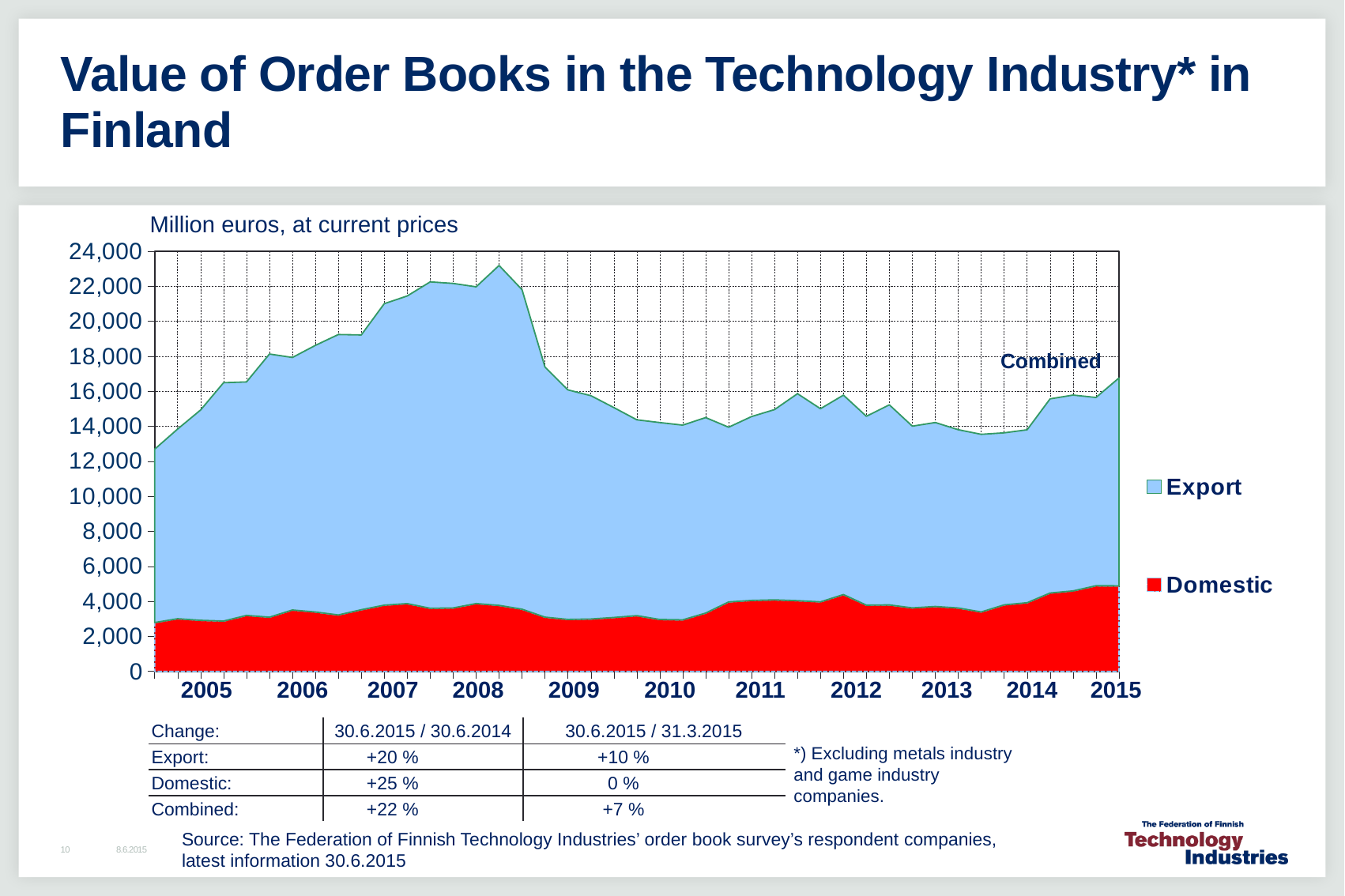
Does the combined value rise or fall between 2005 and the 2008 peak? rise How many year labels appear on the x-axis of the chart? 11 What kind of chart is shown on the slide? Stacked area chart Which two series are listed in the chart legend? Export and Domestic What unit is stated above the chart's y-axis? Million euros, at current prices According to the change table below the chart, what is the Export change for 30.6.2015 / 30.6.2014? +20 % Is the Domestic value at any point in the chart greater or less than 6,000? less Does the combined value rise or fall from the 2008 peak to 2009? fall How many series does the chart legend list? 2 Which series is larger throughout the chart, Export or Domestic? Export Is the combined value at its 2008 peak greater or less than 22,000? greater